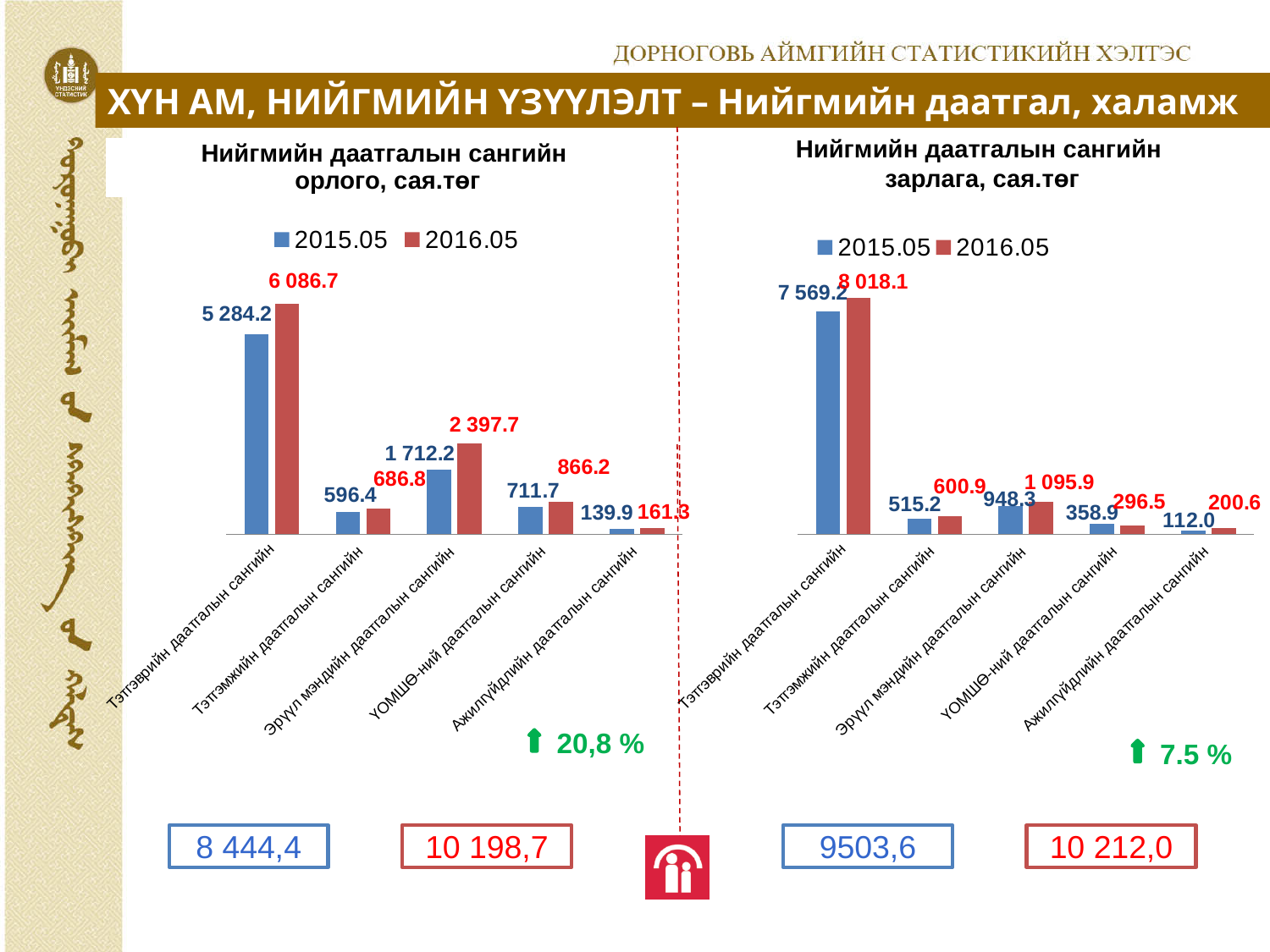
In the right chart (Нийгмийн даатгалын сангийн зарлага, сая.төг), which is larger for ҮОМШӨ-ний даатгалын сангийн: the 2015.05 value or the 2016.05 value? 2015.05 In the right chart (Нийгмийн даатгалын сангийн зарлага, сая.төг), which category has the highest 2016.05 value? Тэтгэврийн даатгалын сангийн How many categories are shown on the x axis of the left chart (Нийгмийн даатгалын сангийн орлого, сая.төг)? 5 In the left chart (Нийгмийн даатгалын сангийн орлого, сая.төг), what is the 2015.05 value for Эрүүл мэндийн даатгалын сангийн? 1 712.2 In the right chart (Нийгмийн даатгалын сангийн зарлага, сая.төг), what is the 2016.05 value for Ажилгүйдлийн даатгалын сангийн? 200.6 In the left chart (Нийгмийн даатгалын сангийн орлого, сая.төг), what is the difference between the 2016.05 and 2015.05 values for Эрүүл мэндийн даатгалын сангийн? 685.5 In the right chart (Нийгмийн даатгалын сангийн зарлага, сая.төг), what is the 2015.05 value for Тэтгэврийн даатгалын сангийн? 7 569.2 In the left chart (Нийгмийн даатгалын сангийн орлого, сая.төг), what is the 2016.05 value for Тэтгэврийн даатгалын сангийн? 6 086.7 How many series does the legend of the right chart (Нийгмийн даатгалын сангийн зарлага, сая.төг) list? 2 What type of chart is the left chart (Нийгмийн даатгалын сангийн орлого, сая.төг)? Bar chart In the right chart (Нийгмийн даатгалын сангийн зарлага, сая.төг), what is the difference between the 2016.05 and 2015.05 values for Тэтгэврийн даатгалын сангийн? 448.9 In the left chart (Нийгмийн даатгалын сангийн орлого, сая.төг), which category has the lowest 2015.05 value? Ажилгүйдлийн даатгалын сангийн